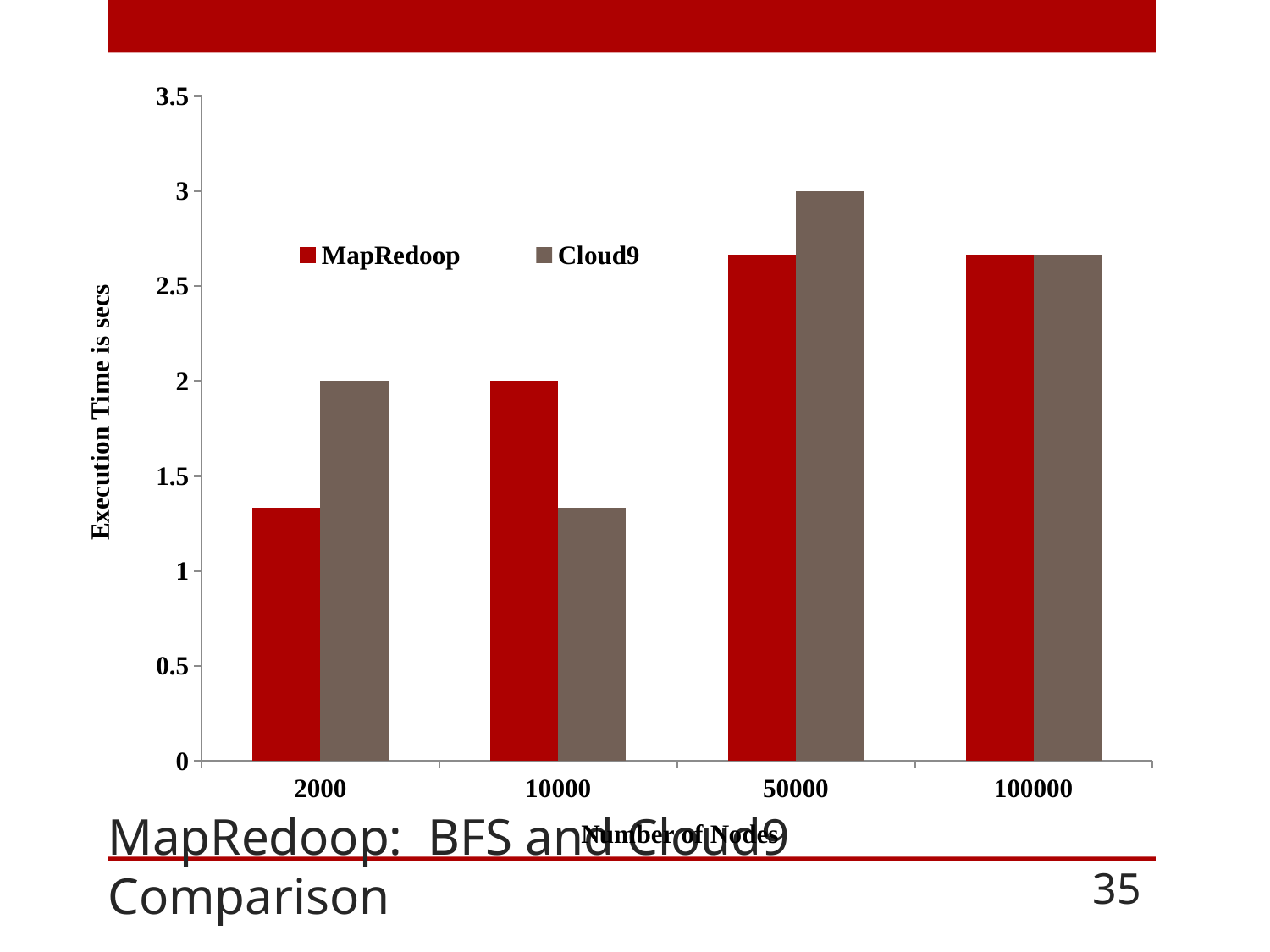
At 2000 nodes, which has the larger execution time, MapRedoop or Cloud9? Cloud9 At which number of nodes is the MapRedoop execution time lowest? 2000 What is the execution time for Cloud9 at 2000 nodes? 2 At 10000 nodes, which has the larger execution time, MapRedoop or Cloud9? MapRedoop What kind of chart is shown on the slide? bar chart At which number of nodes is the Cloud9 execution time highest? 50000 How many node-count categories are shown on the x axis? 4 What is the execution time for MapRedoop at 10000 nodes? 2 How many series does the legend list? 2 What is the label of the y axis? Execution Time is secs Is the execution time for MapRedoop at 2000 nodes greater or less than 1.5? less What is the execution time for Cloud9 at 50000 nodes? 3